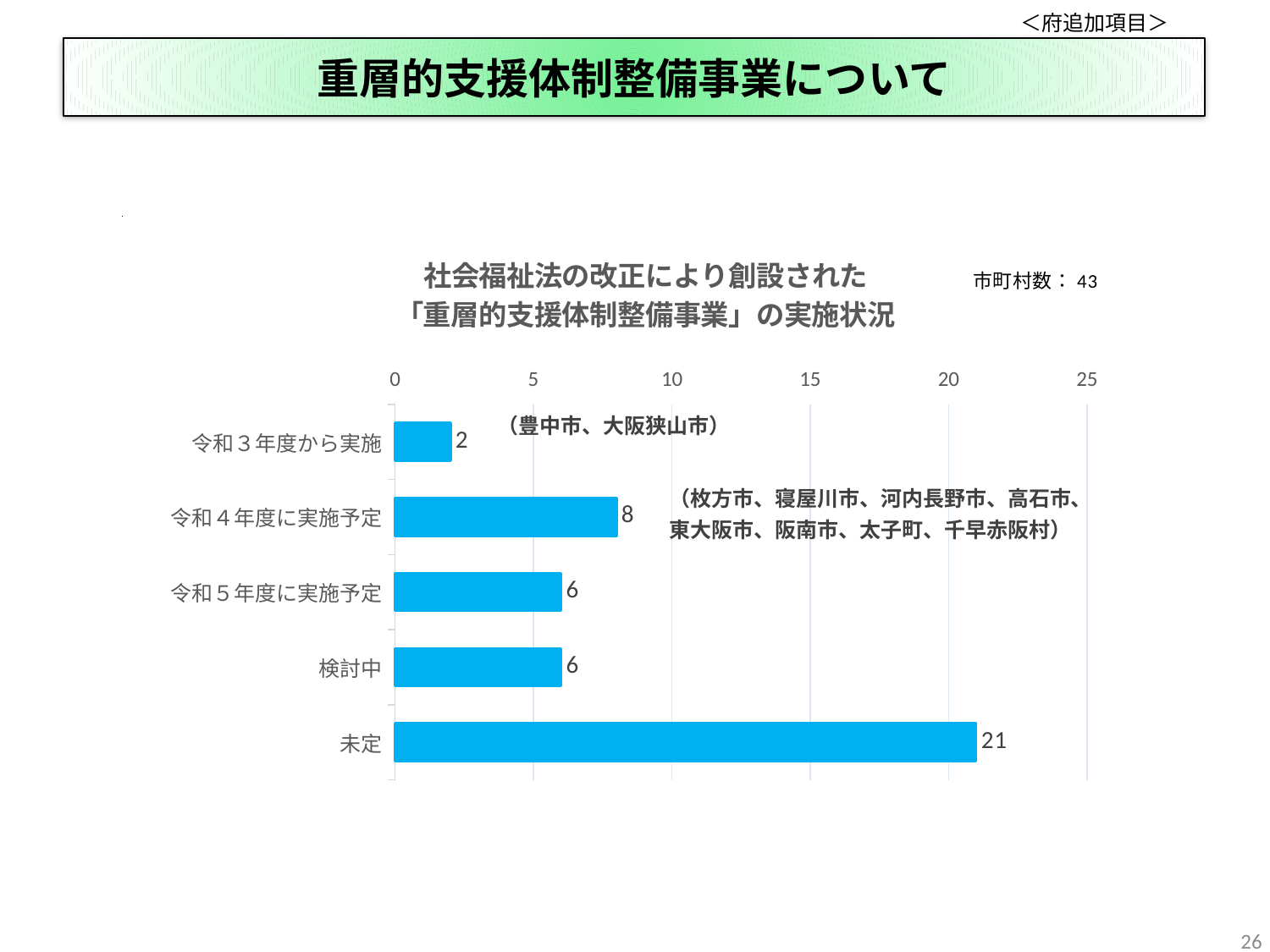
What is the total number of municipalities (市町村数) noted next to the chart title? 43 How many categories are shown in the chart? 5 Which category has the lowest value? 令和３年度から実施 What is the value for 検討中? 6 Which category has the highest value? 未定 Is the value for 未定 greater or less than 20? greater Which is larger, the value for 令和４年度に実施予定 or the value for 令和５年度に実施予定? 令和４年度に実施予定 What kind of chart is shown on the slide? bar chart What is the difference between the values for 未定 and 令和４年度に実施予定? 13 What is the value for 令和３年度から実施? 2 What is the value for 未定? 21 What is the value for 令和４年度に実施予定? 8